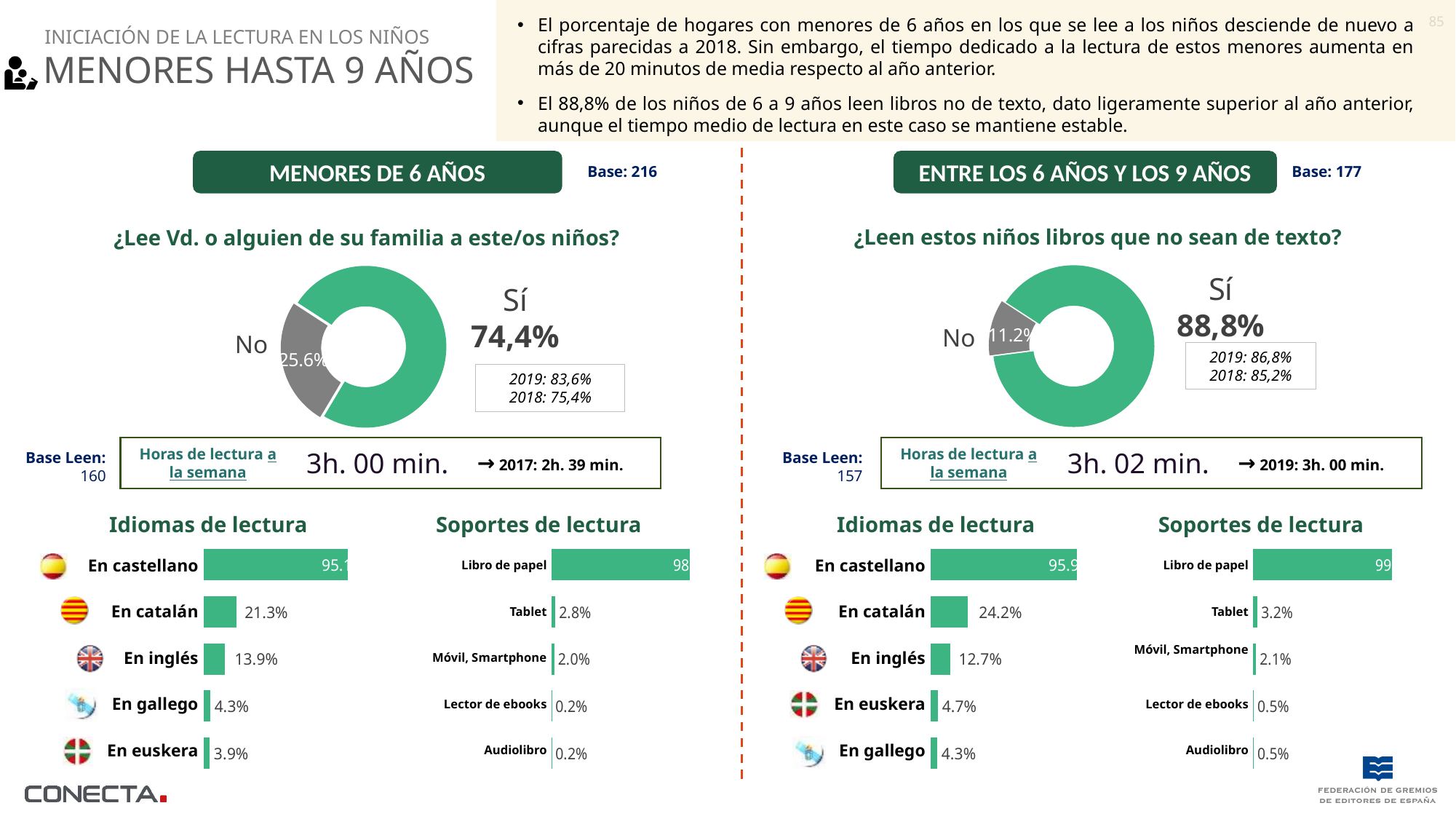
In the 'Idiomas de lectura' bar chart for 'Entre los 6 años y los 9 años', what is the value for En inglés? 12.7% In the 'Idiomas de lectura' bar chart for 'Menores de 6 años', what is the value for En catalán? 21.3% In the donut chart for 'Entre los 6 años y los 9 años' (¿Leen estos niños libros que no sean de texto?), what percentage answered Sí? 88,8% In the 'Soportes de lectura' bar chart for 'Menores de 6 años', what is the value for Tablet? 2.8% In the 'Soportes de lectura' bar chart for 'Entre los 6 años y los 9 años', which is larger, Tablet or Móvil, Smartphone? Tablet In the donut chart for 'Menores de 6 años' (¿Lee Vd. o alguien de su familia a este/os niños?), what percentage answered Sí? 74,4% How many categories are shown in the 'Soportes de lectura' bar chart for 'Entre los 6 años y los 9 años'? 5 In the donut chart for 'Entre los 6 años y los 9 años', what percentage answered No? 11.2% In the donut chart for 'Menores de 6 años', what percentage answered No? 25.6% What type of chart is used for '¿Lee Vd. o alguien de su familia a este/os niños?'? Donut chart In the 'Idiomas de lectura' bar chart for 'Menores de 6 años', which language has the lowest value? En euskera In the 'Idiomas de lectura' bar chart for 'Entre los 6 años y los 9 años', what is the difference between En catalán and En inglés? 11.5%